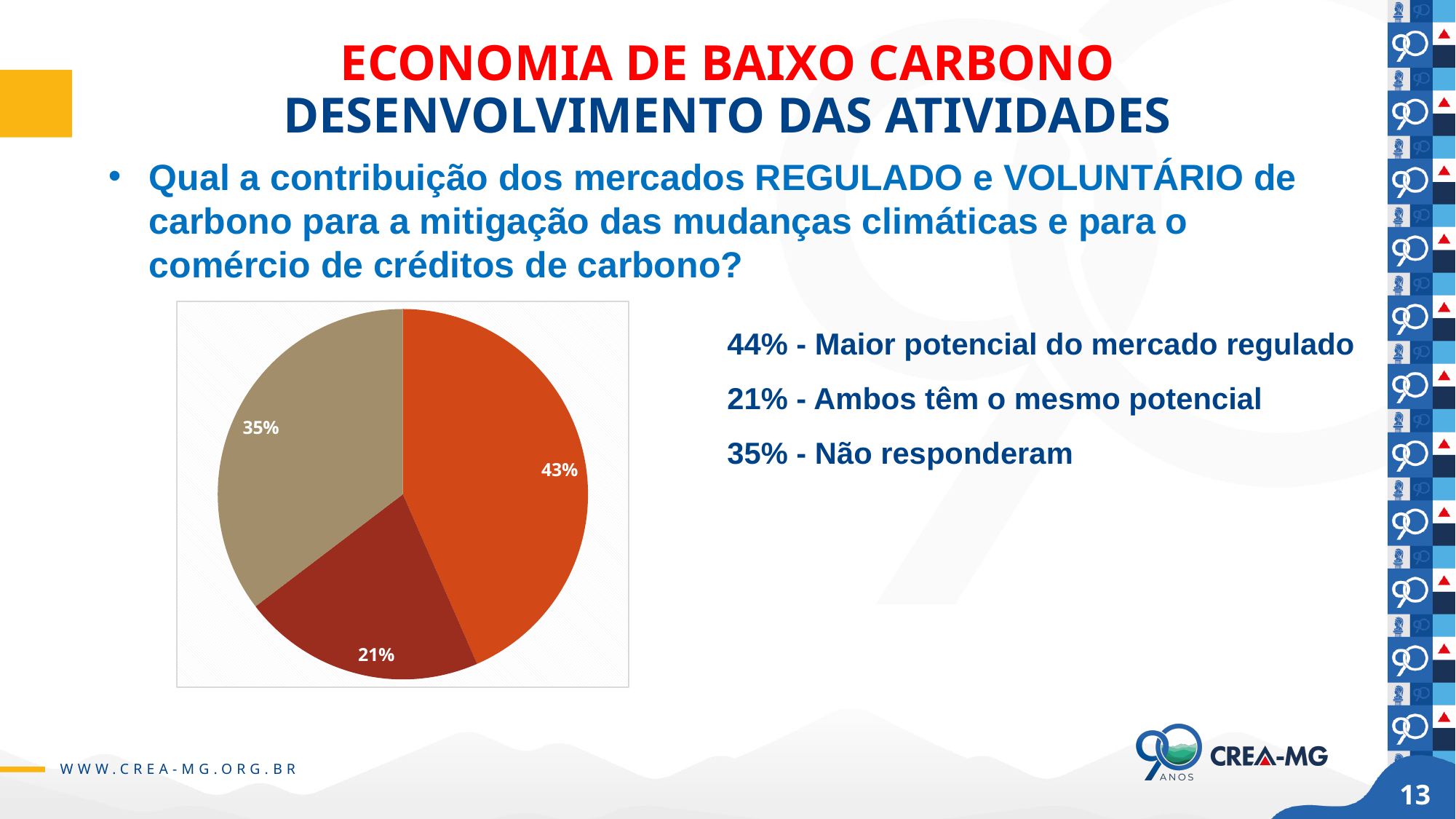
Is the share of respondents who did not answer (Não responderam) greater or less than 25%? greater According to the pie chart, what share of respondents did not answer (Não responderam)? 35% What is the value printed on the smallest slice of the pie chart? 21% Which slice is larger in the pie chart: the 35% slice or the 21% slice? the 35% slice How many slices does the pie chart have? 3 What colour is the 35% slice of the pie chart? beige/tan What colour is the largest slice of the pie chart? orange According to the pie chart, what share of respondents said both markets have the same potential (Ambos têm o mesmo potencial)? 21% What is the difference in percentage points between the largest slice (43%) and the smallest slice (21%) of the pie chart? 22 percentage points What is the difference in percentage points between the 43% slice and the 35% slice of the pie chart? 8 percentage points What kind of chart is shown on the slide? pie chart What is the value printed on the largest slice of the pie chart? 43%